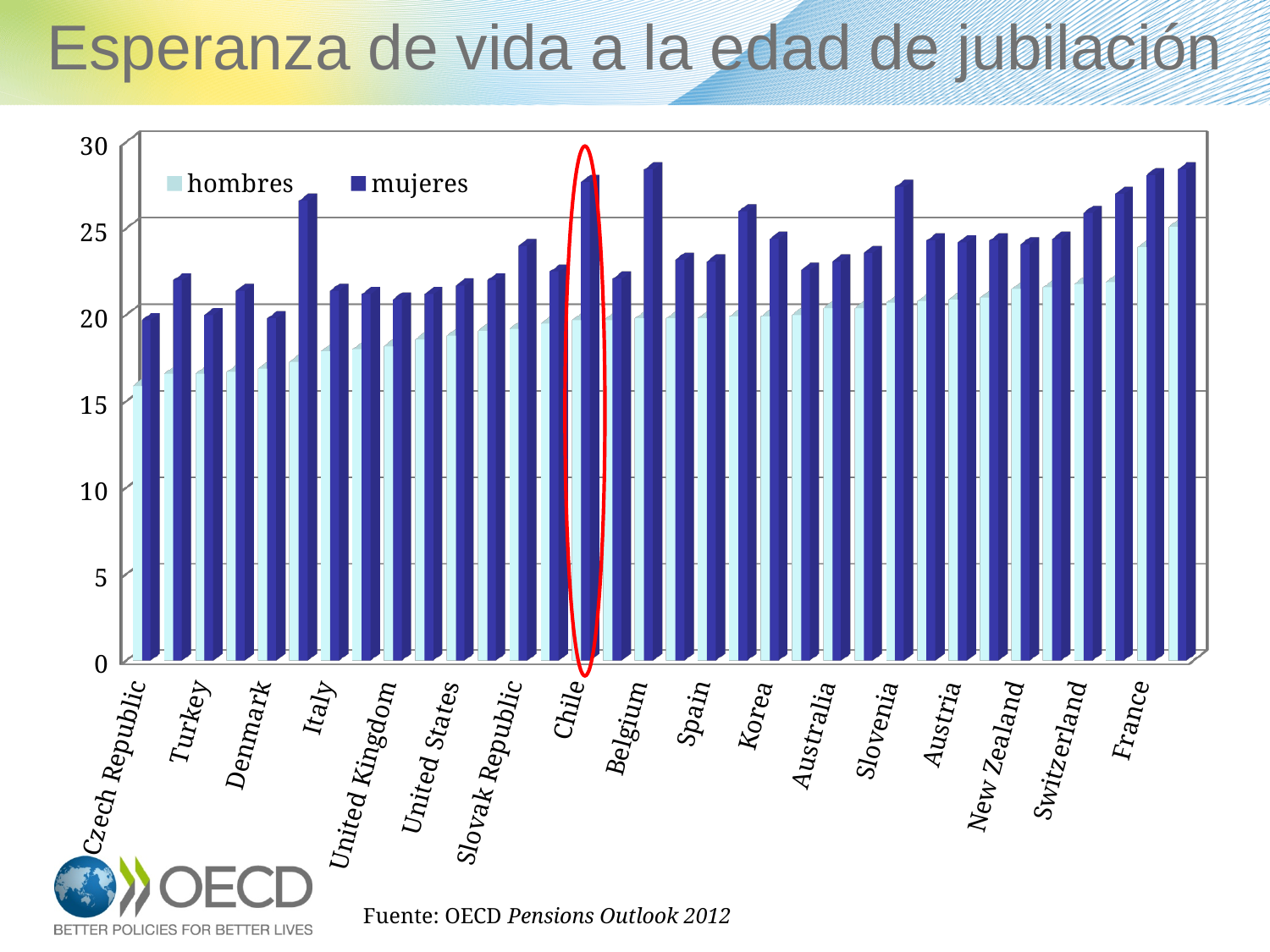
What are the two series named in the legend? hombres and mujeres What kind of chart is shown on the slide? bar chart Is the hombres value for Denmark greater or less than 20? less Is the mujeres value for Turkey greater or less than 25? less Is the mujeres value for Chile greater or less than 25? greater Which country has the lowest hombres value? Czech Republic Which country's bars are circled in red on the chart? Chile For Chile, which is larger, the hombres value or the mujeres value? mujeres Do the hombres values generally rise or fall from left to right along the x axis? rise How many series does the legend list? 2